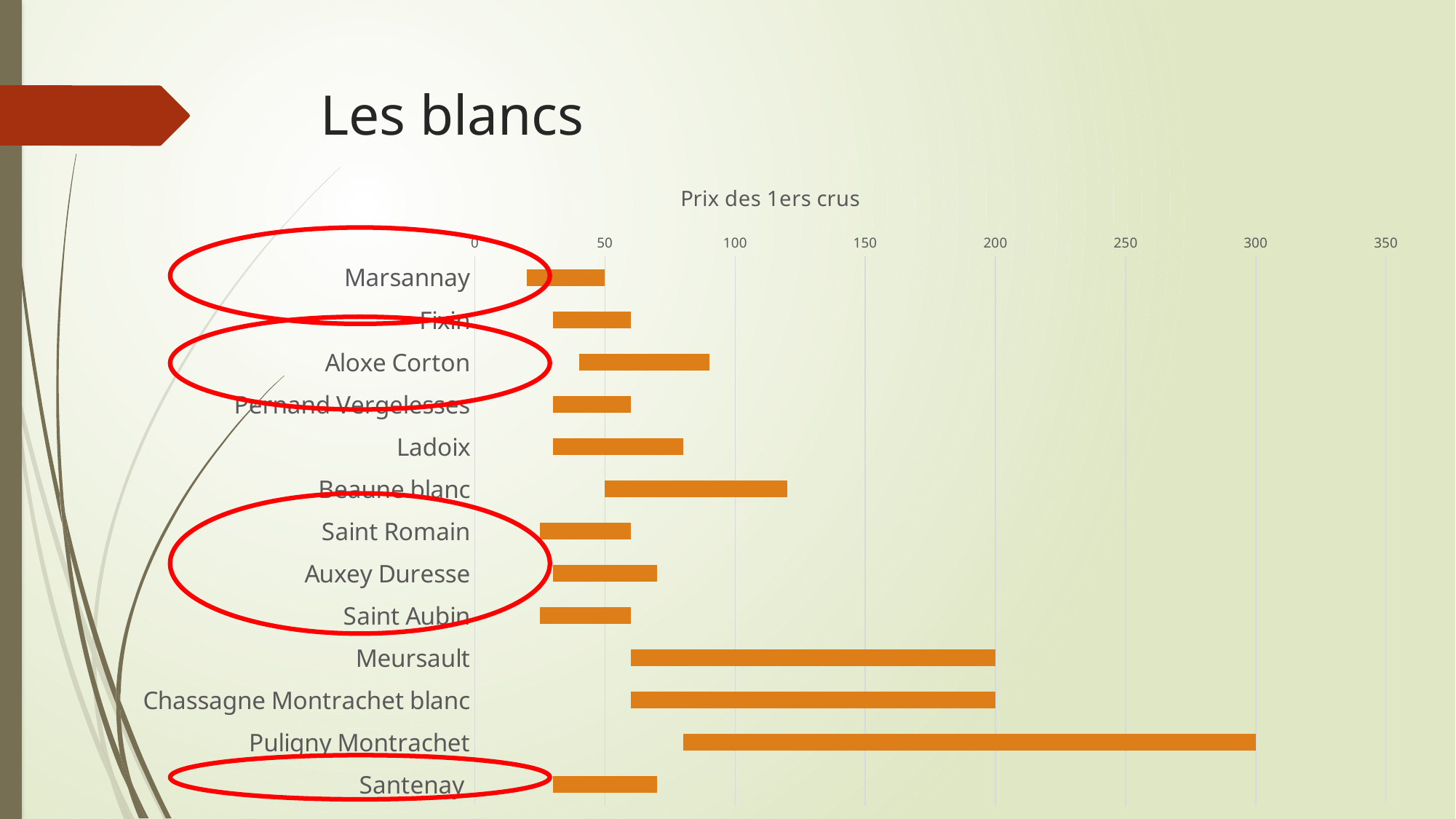
Which bar reaches a higher value, Puligny Montrachet or Meursault? Puligny Montrachet Is the upper end of the Marsannay bar greater or less than 100? less Is the upper end of the Puligny Montrachet bar greater or less than 250? greater At what value on the axis does the Meursault bar end? 200 Which bar reaches a higher value, Beaune blanc or Ladoix? Beaune blanc How many categories (appellations) are listed on the chart? 13 Is the upper end of the Beaune blanc bar greater or less than 100? greater Which category's bar extends furthest to the right (highest price)? Puligny Montrachet What is the title of the chart? Prix des 1ers crus What kind of chart is shown on the slide? bar chart At what value on the axis does the Puligny Montrachet bar end? 300